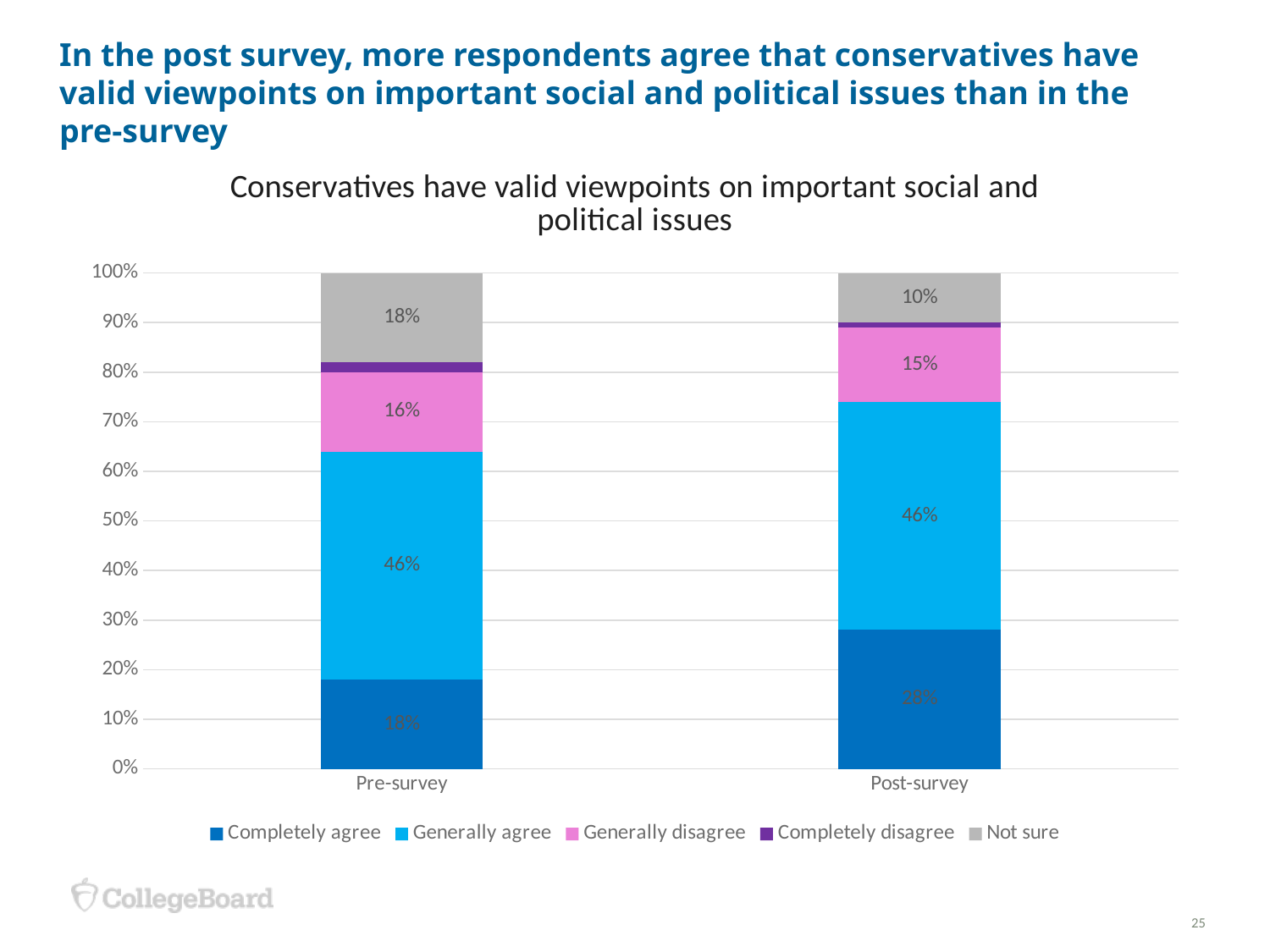
Which series is the largest segment in the Pre-survey bar? Generally agree Which survey has the larger "Completely agree" share, Pre-survey or Post-survey? Post-survey What is the "Generally disagree" value for the Post-survey bar? 15% How many series does the legend list? 5 How many categories are shown on the x axis? 2 What is the "Not sure" value for the Pre-survey bar? 18% What is the "Generally agree" value for the Post-survey bar? 46% What percentage of Pre-survey respondents said "Completely agree"? 18% What is the title of the chart? Conservatives have valid viewpoints on important social and political issues What percentage of Post-survey respondents said "Completely agree"? 28% What kind of chart is shown on the slide? Stacked bar chart By how many percentage points did the "Not sure" share fall from Pre-survey to Post-survey? 8 percentage points